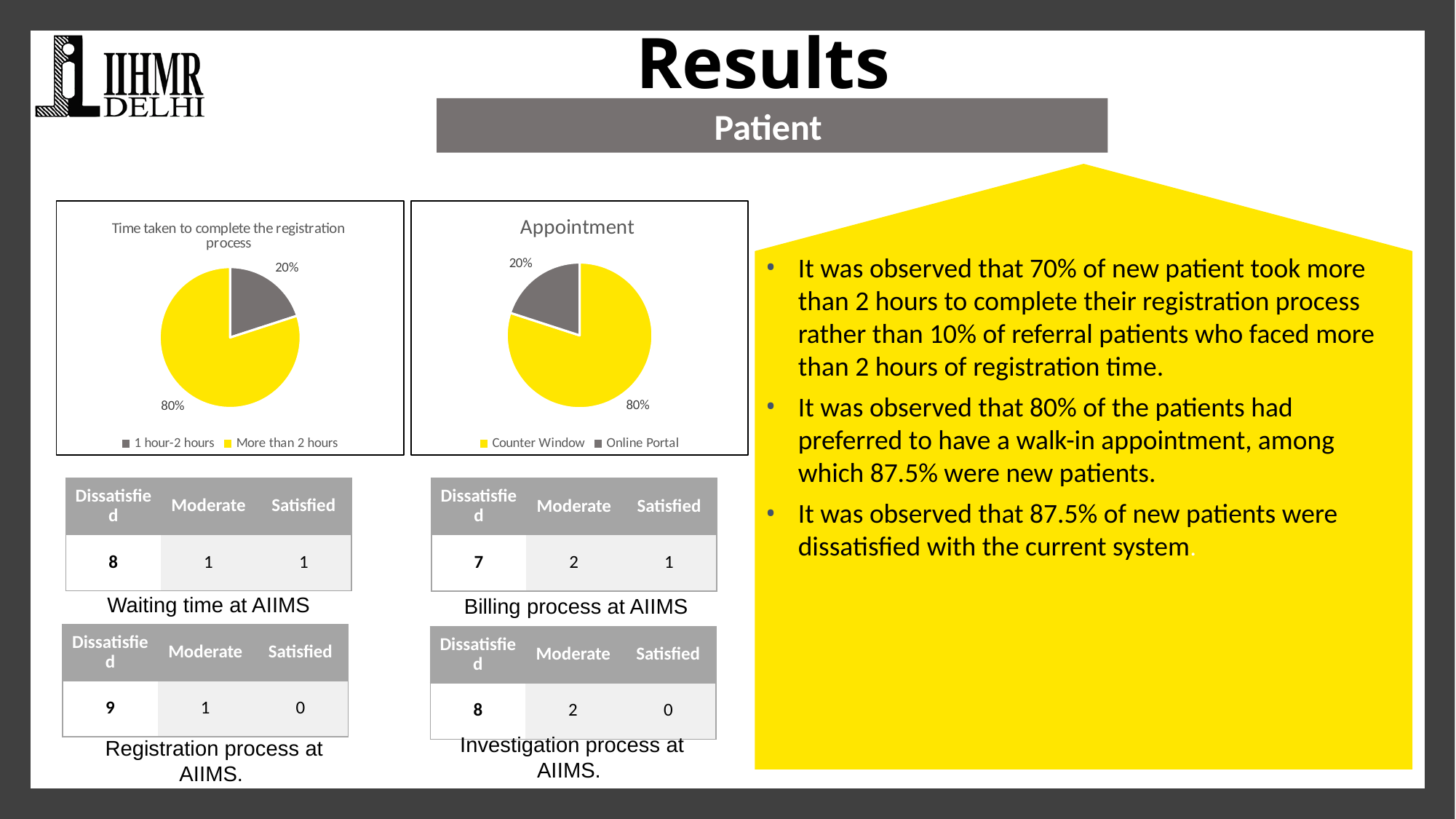
In the 'Appointment' chart, which category has the smallest slice? Online Portal In the 'Time taken to complete the registration process' chart, what share of the pie is '1 hour-2 hours'? 20% What kind of chart is the 'Appointment' chart? Pie chart In the 'Appointment' chart, what share of the pie is 'Online Portal'? 20% In the 'Time taken to complete the registration process' chart, which category has the largest slice? More than 2 hours In the 'Time taken to complete the registration process' chart, which is larger: '1 hour-2 hours' or 'More than 2 hours'? More than 2 hours In the 'Appointment' chart, what share of the pie is 'Counter Window'? 80% In the 'Appointment' chart, what colour is the 'Counter Window' slice? Yellow How many categories does the 'Time taken to complete the registration process' chart show? 2 In the 'Appointment' chart, what is the difference in percentage points between 'Counter Window' and 'Online Portal'? 60 How many entries does the legend of the 'Appointment' chart list? 2